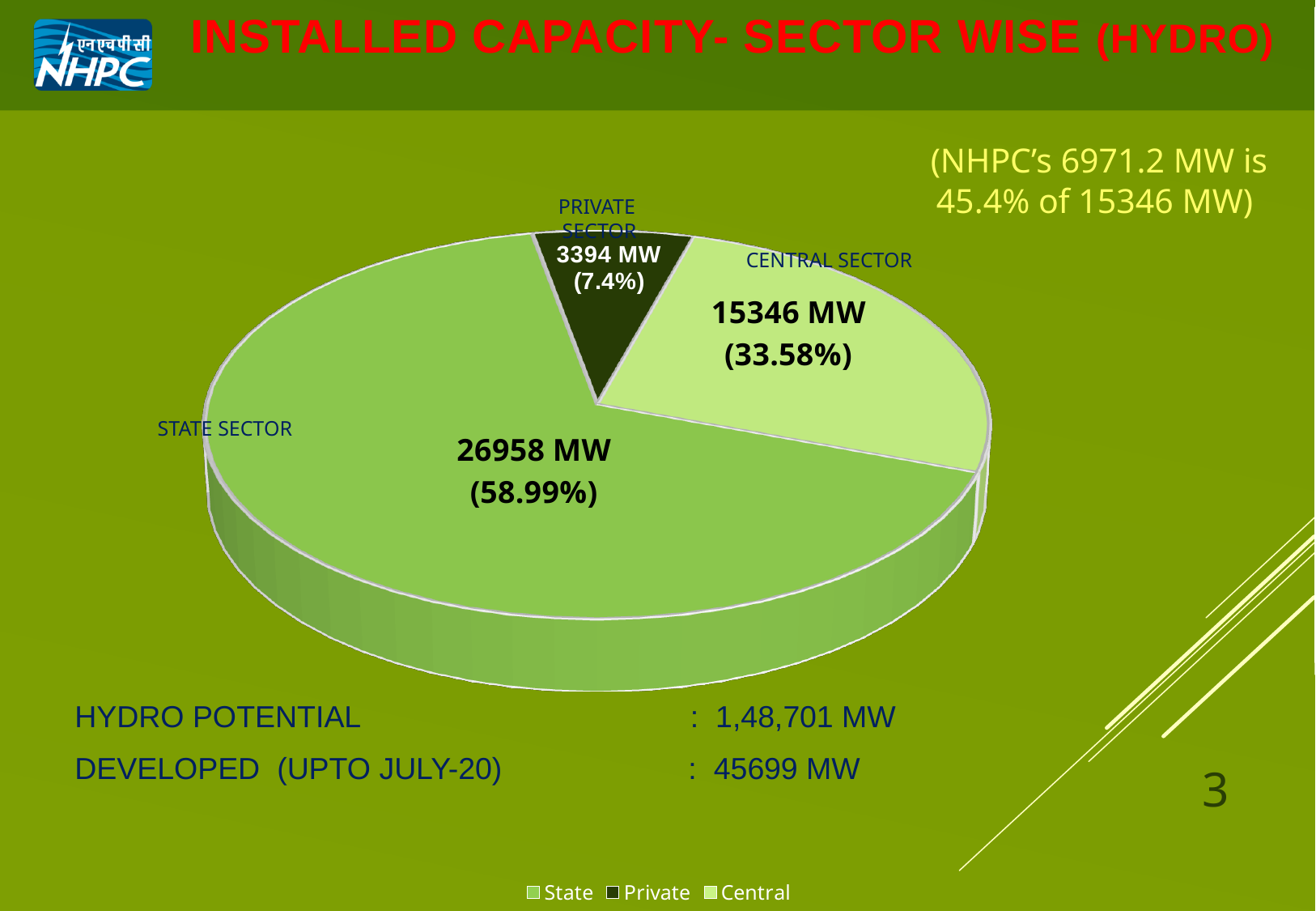
How many sectors are shown in the pie chart? 3 Which sector has the smallest share of installed hydro capacity? Private Sector What is the difference in installed capacity between the State Sector and the Central Sector? 11612 MW Which is larger, the Central Sector capacity or the Private Sector capacity? Central Sector What is the installed capacity of the State Sector? 26958 MW What percentage share of the pie does the Central Sector hold? 33.58% What percentage share of the pie does the Private Sector hold? 7.4% What type of chart is shown on the slide? Pie chart How many entries does the legend list? 3 What is the installed capacity of the Central Sector? 15346 MW Which sector has the largest share of installed hydro capacity? State Sector What is the installed capacity of the Private Sector? 3394 MW